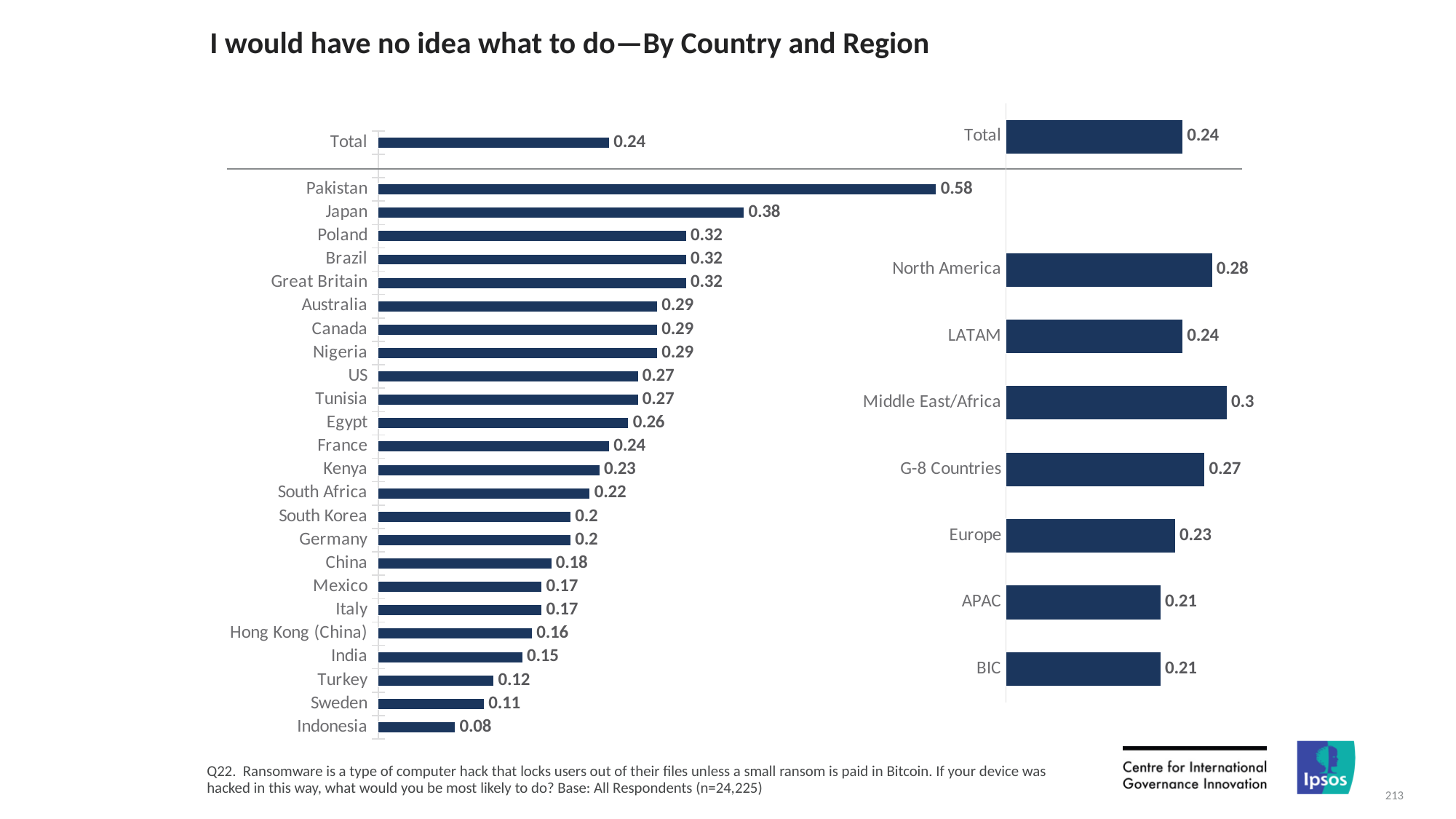
In the left chart (by country), what is the value for Pakistan? 0.58 In the left chart (by country), how many countries are listed below the Total bar? 24 In the left chart (by country), which country has the highest value? Pakistan In the right chart (by region), what is the difference between the values for North America and Europe? 0.05 In the left chart (by country), what is the difference between the values for Pakistan and Japan? 0.2 In the right chart (by region), how many regions are shown, excluding Total? 7 In the left chart (by country), what is the value for Indonesia? 0.08 What type of chart is used on this slide? Bar chart In the right chart (by region), what is the value for Middle East/Africa? 0.3 In the left chart (by country), which country has the lowest value? Indonesia In the right chart (by region), which region has the highest value? Middle East/Africa In the left chart (by country), which has the larger value, Egypt or Kenya? Egypt